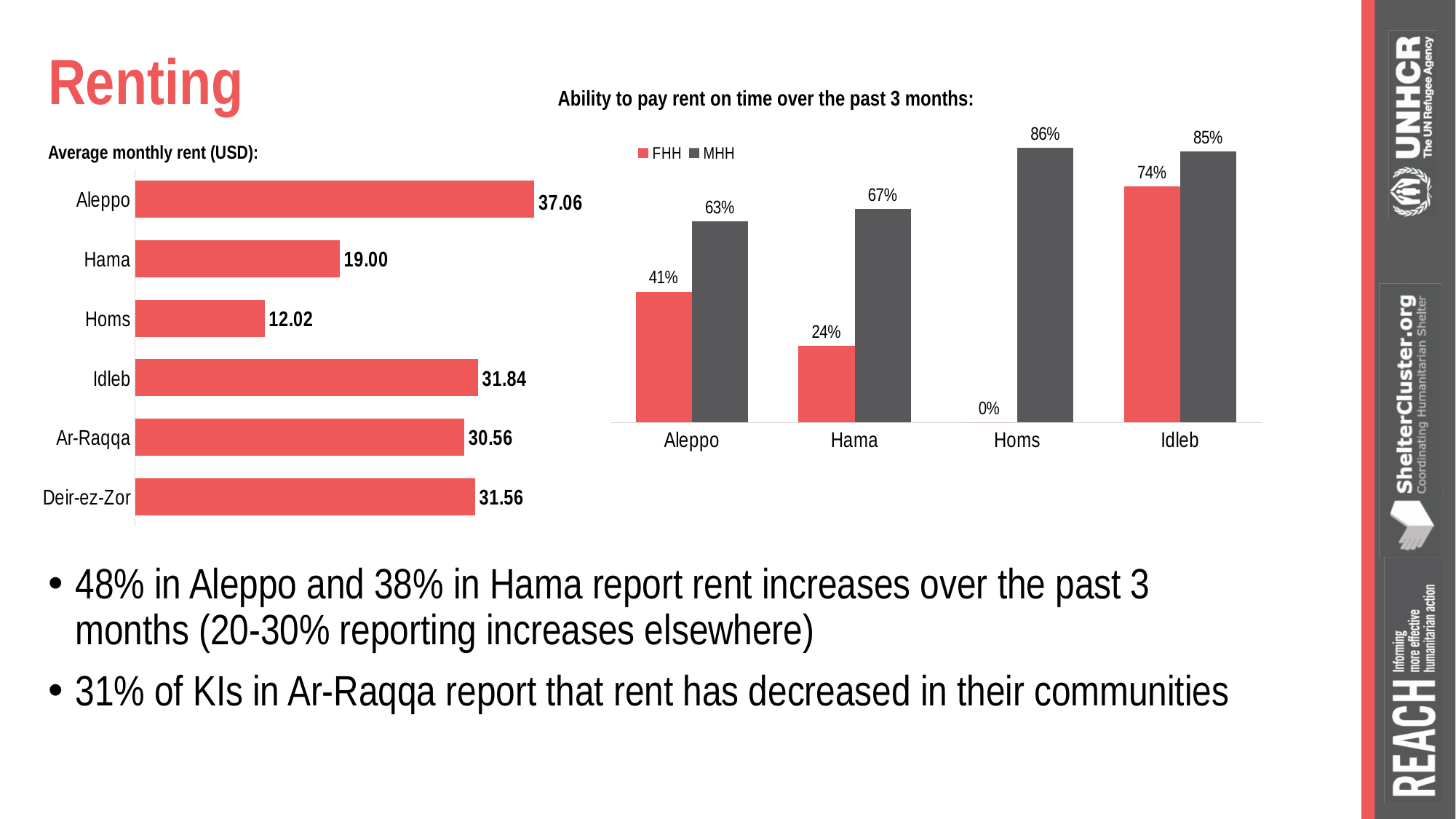
In the 'Average monthly rent (USD)' chart, what is the difference between the values for Aleppo and Hama? 18.06 In the 'Ability to pay rent on time over the past 3 months' chart, how many series does the legend list? 2 What kind of chart is the 'Ability to pay rent on time over the past 3 months' chart? Bar chart In the 'Ability to pay rent on time over the past 3 months' chart, what is the FHH value for Hama? 24% In the 'Average monthly rent (USD)' chart, which category has the highest value? Aleppo In the 'Average monthly rent (USD)' chart, what is the value for Aleppo? 37.06 In the 'Ability to pay rent on time over the past 3 months' chart, which category has the lowest FHH value? Homs In the 'Average monthly rent (USD)' chart, how many categories are shown? 6 In the 'Average monthly rent (USD)' chart, which is larger, the value for Idleb or the value for Deir-ez-Zor? Idleb In the 'Average monthly rent (USD)' chart, which category has the lowest value? Homs In the 'Ability to pay rent on time over the past 3 months' chart, what is the MHH value for Homs? 86% In the 'Ability to pay rent on time over the past 3 months' chart, what is the difference between the MHH and FHH values for Aleppo? 22%